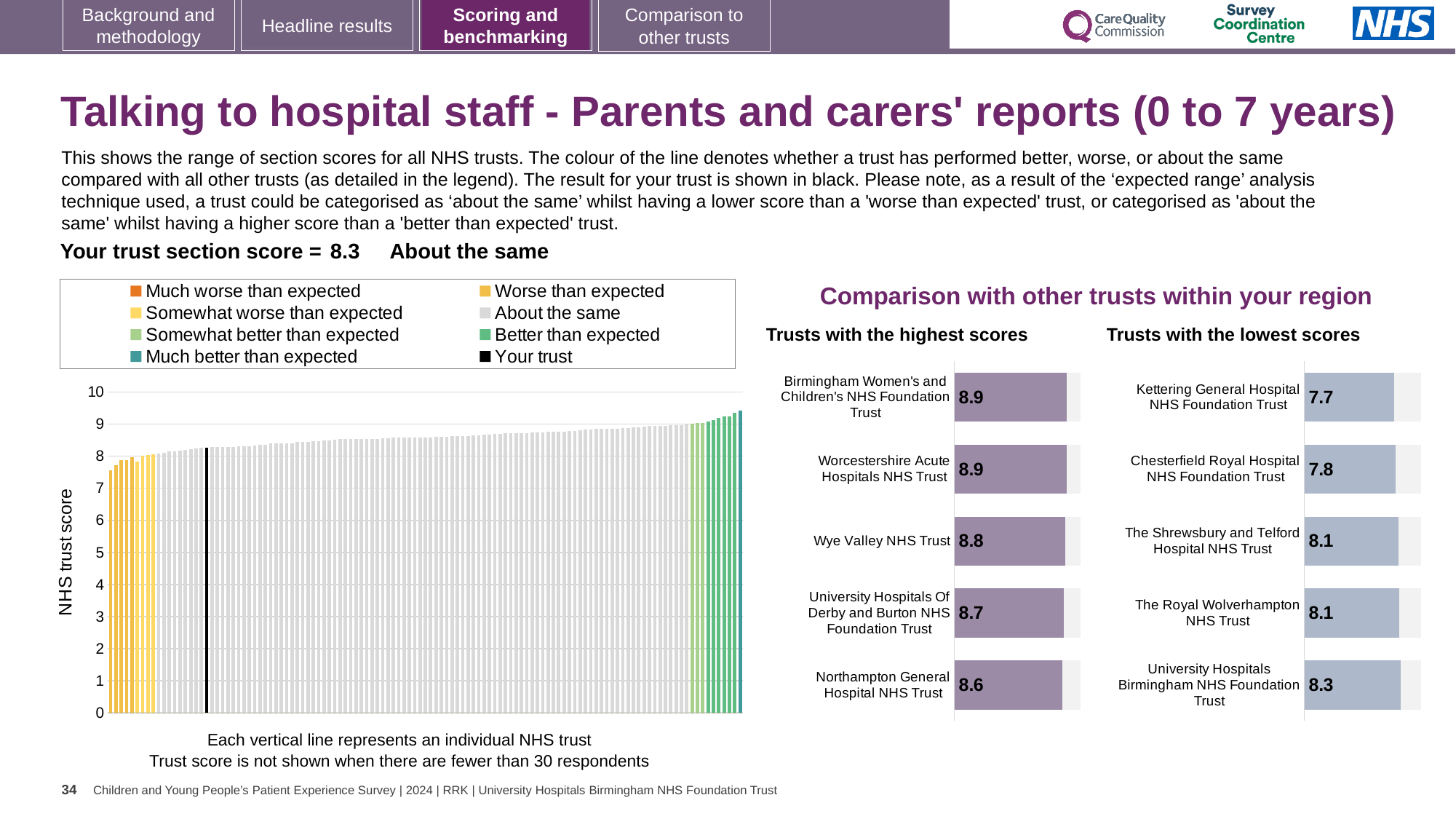
What kind of chart is the large chart on the left showing NHS trust scores? Bar chart In the 'Trusts with the highest scores' chart, what is the score for Wye Valley NHS Trust? 8.8 In the 'Trusts with the lowest scores' chart, what is the difference between the scores of University Hospitals Birmingham NHS Foundation Trust and Kettering General Hospital NHS Foundation Trust? 0.6 In the 'Trusts with the lowest scores' chart, which has the higher score: Chesterfield Royal Hospital NHS Foundation Trust or The Shrewsbury and Telford Hospital NHS Trust? The Shrewsbury and Telford Hospital NHS Trust In the 'Trusts with the lowest scores' chart, which trust has the highest score? University Hospitals Birmingham NHS Foundation Trust In the 'Trusts with the lowest scores' chart, what is the score for Kettering General Hospital NHS Foundation Trust? 7.7 In the 'Trusts with the highest scores' chart, which trust has the lowest score? Northampton General Hospital NHS Trust How many entries does the legend of the large chart on the left list? 8 In the large chart on the left, is the value of the highest bar greater or less than 9? greater In the large chart on the left, is the value of the lowest bar greater or less than 8? less How many trusts are listed in the 'Trusts with the highest scores' chart? 5 In the 'Trusts with the highest scores' chart, what is the difference between the scores of Wye Valley NHS Trust and Northampton General Hospital NHS Trust? 0.2